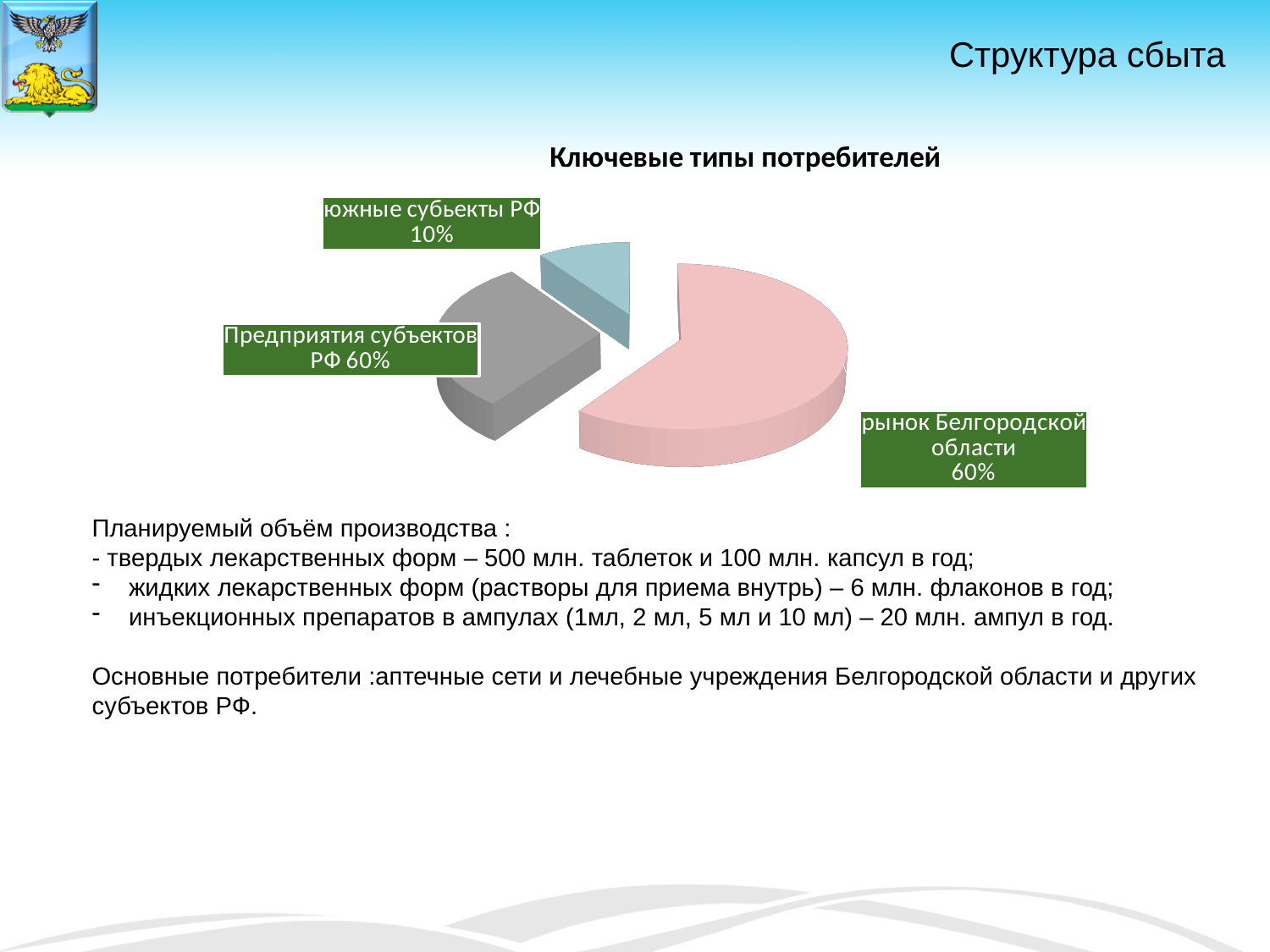
How many slices does the pie chart have? 3 What colour is the slice for "рынок Белгородской области"? Pink What is the title of the chart? Ключевые типы потребителей By how many percentage points does the labelled share for "рынок Белгородской области" exceed that for "южные субьекты РФ"? 50 percentage points Which slice of the pie chart is the smallest? южные субьекты РФ What share is labelled for "южные субьекты РФ"? 10% What share is labelled for "рынок Белгородской области"? 60% What share is labelled for "Предприятия субъектов РФ"? 60% Which is larger: the share for "рынок Белгородской области" or the share for "южные субьекты РФ"? рынок Белгородской области What kind of chart is shown on the slide? Pie chart